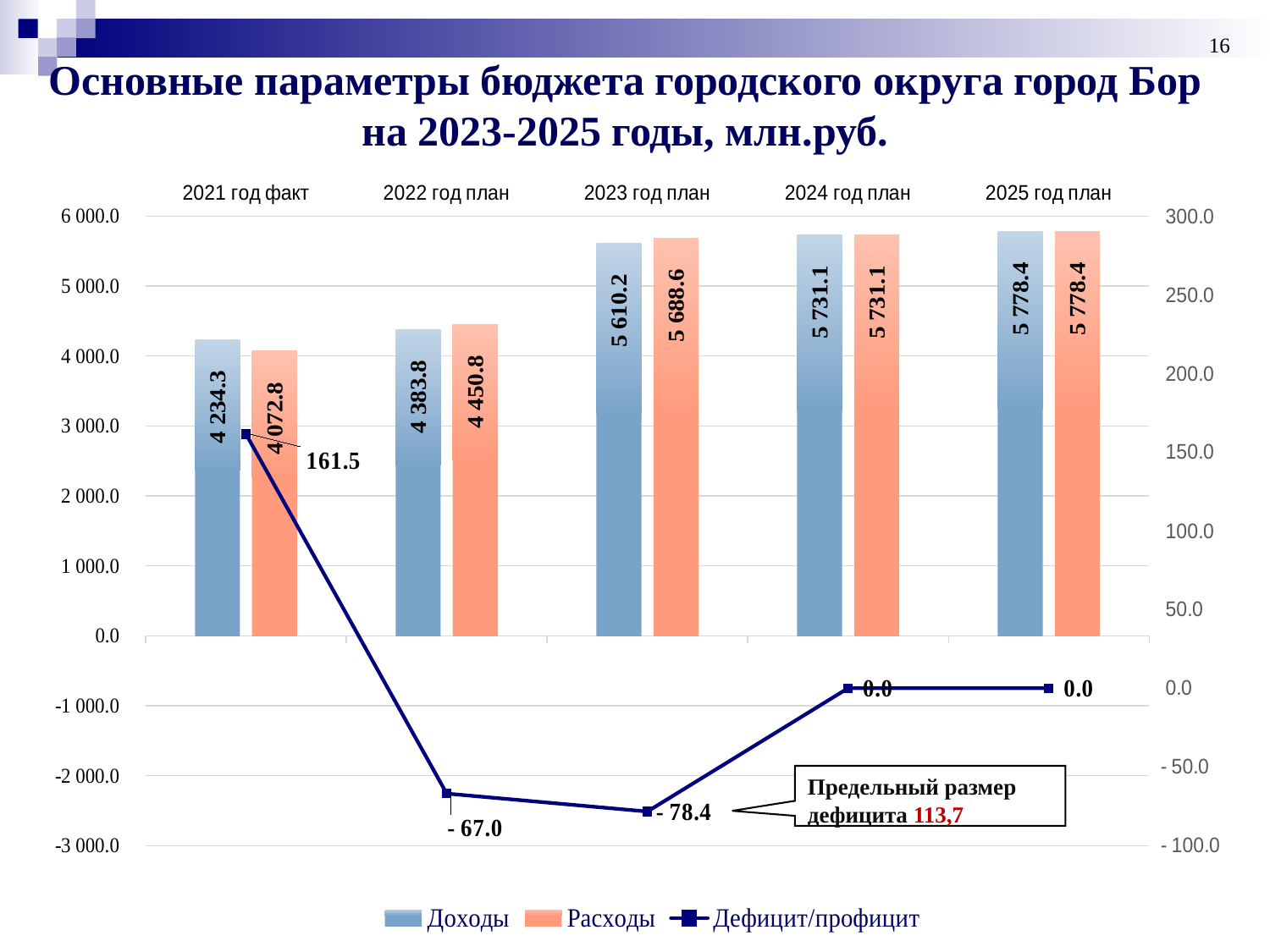
Which year has the highest value of Доходы? 2025 год план What is the difference between Доходы for 2025 год план and Доходы for 2024 год план? 47.3 What is the difference between Расходы and Доходы for 2022 год план? 67.0 Do the Доходы values rise or fall from 2021 год факт to 2025 год план? rise How many series does the legend list? 3 What is the value of Дефицит/профицит for 2022 год план? - 67.0 Which year has the lowest value of Расходы? 2021 год факт How many years are shown on the x axis? 5 What is the value of Доходы for 2021 год факт? 4 234.3 What is the value of Расходы for 2023 год план? 5 688.6 Which is larger for 2021 год факт: Доходы or Расходы? Доходы What is the value of Дефицит/профицит for 2021 год факт? 161.5